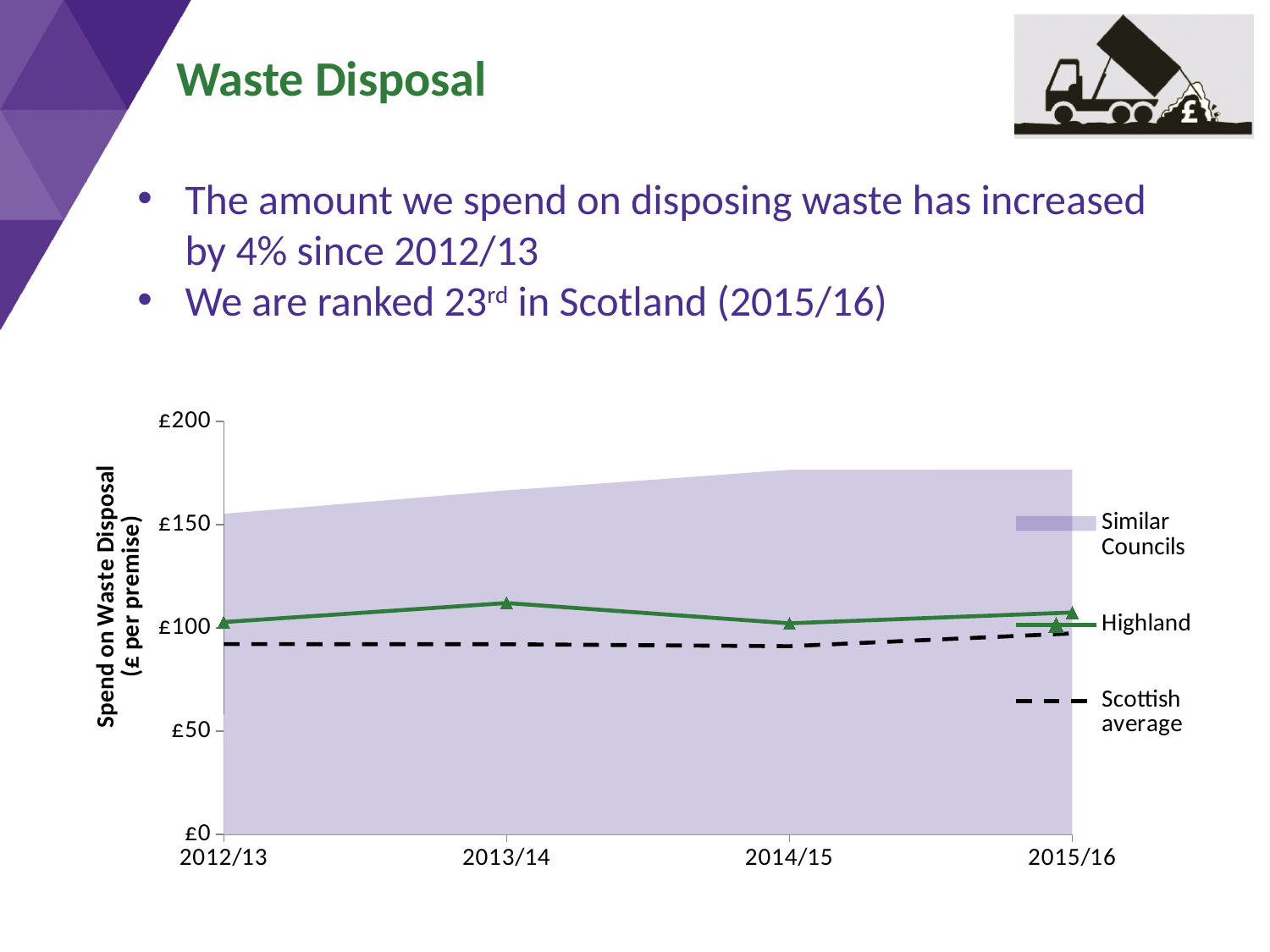
In which year is the Highland value highest? 2013/14 Is the Highland value for 2013/14 greater or less than £150? less In 2013/14, which is larger: the Highland value or the Scottish average? Highland Is the Scottish average value for 2012/13 greater or less than £100? less Which series in the chart is drawn as a dashed line? Scottish average How many series does the chart legend list? 3 Does the Scottish average rise or fall between 2014/15 and 2015/16? rise What kind of chart is shown on the slide? combination area and line chart Is the Highland value for 2013/14 greater or less than £100? greater What is the title of the y axis of the chart? Spend on Waste Disposal (£ per premise) How many years are shown along the x axis of the chart? 4